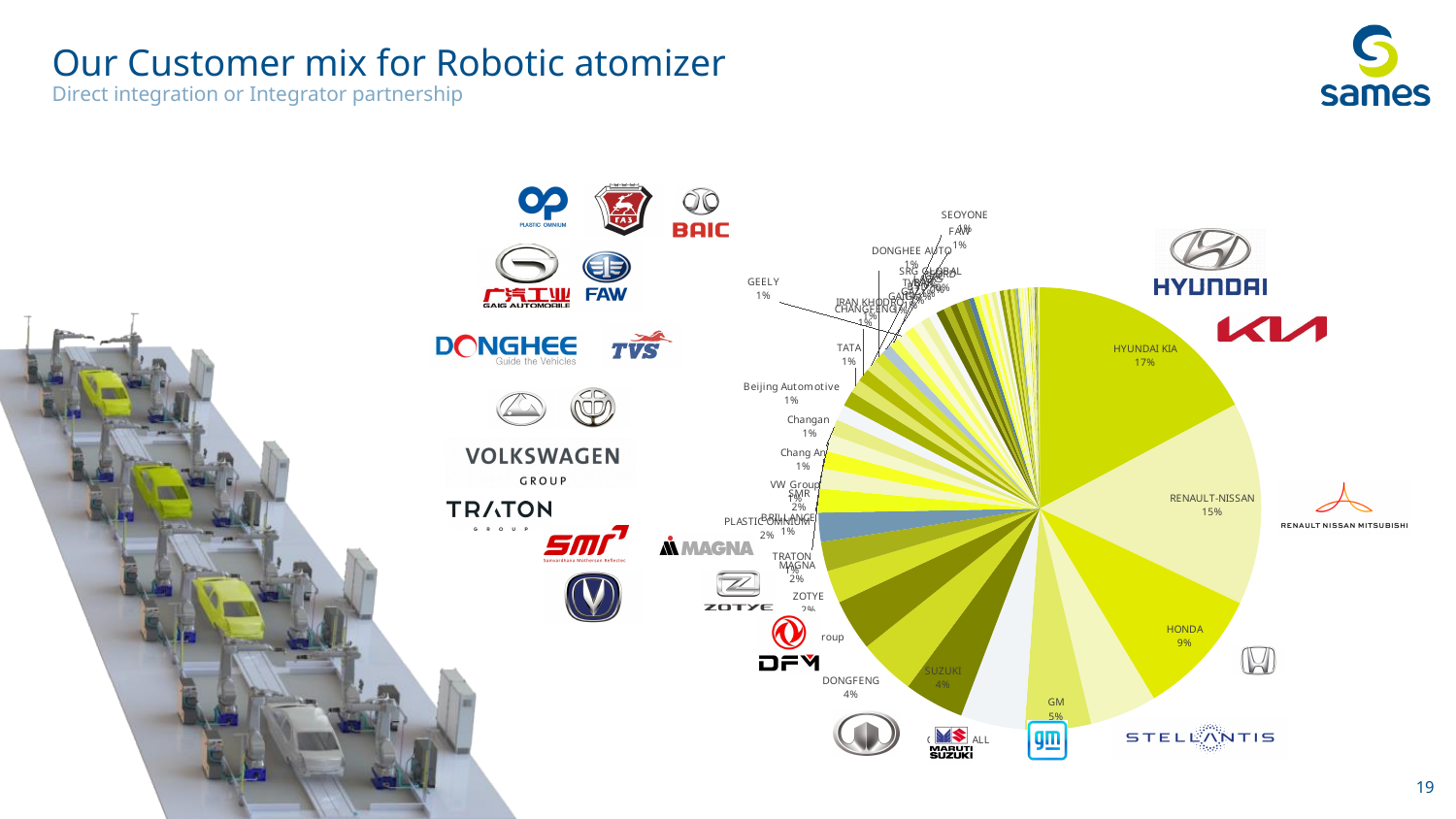
What is the value shown for SUZUKI? 4% Which is larger, the share for HONDA or the share for GM? HONDA What is the value shown for HONDA? 9% What is the value shown for GEELY? 1% Which customer has the largest slice of the pie? HYUNDAI KIA What is the value shown for GM? 5% What is the value shown for DONGFENG? 4% What share of the customer mix does RENAULT-NISSAN hold? 15% What is the title of the slide containing the chart? Our Customer mix for Robotic atomizer What kind of chart is shown on the slide? pie chart What is the difference between the HYUNDAI KIA share and the RENAULT-NISSAN share? 2% What share of the customer mix does HYUNDAI KIA hold? 17%